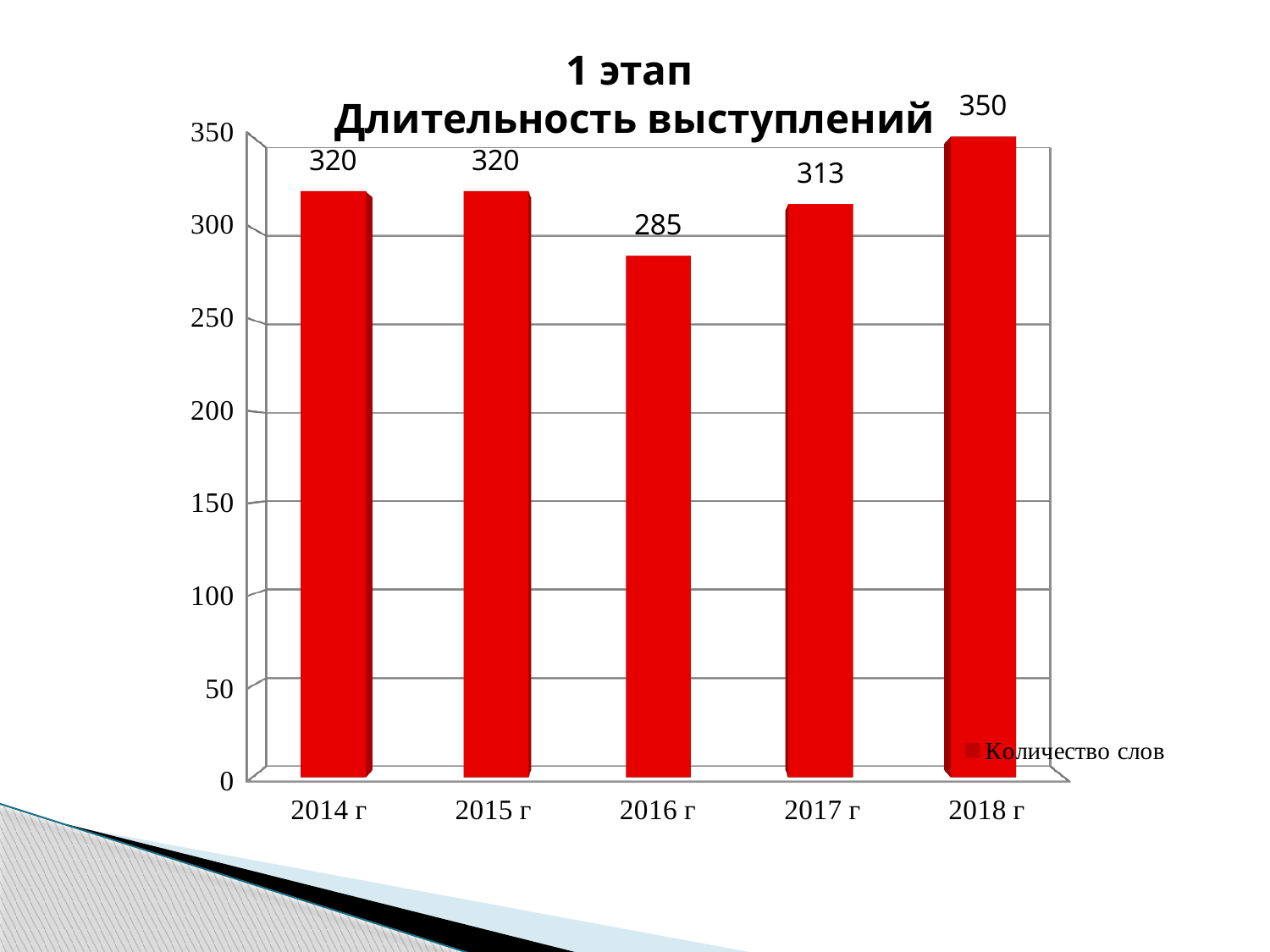
How many series does the legend list? 1 What is the difference between the values for 2014 г and 2017 г? 7 Which year has the lowest value? 2016 г What is the value for 2017 г? 313 What is the legend entry of the chart? Количество слов What is the value for 2018 г? 350 What kind of chart is shown on the slide? bar chart What is the value for 2016 г? 285 What is the difference between the values for 2018 г and 2016 г? 65 Which year has the highest value? 2018 г Which is larger, the value for 2017 г or the value for 2016 г? 2017 г How many years are shown on the x axis? 5